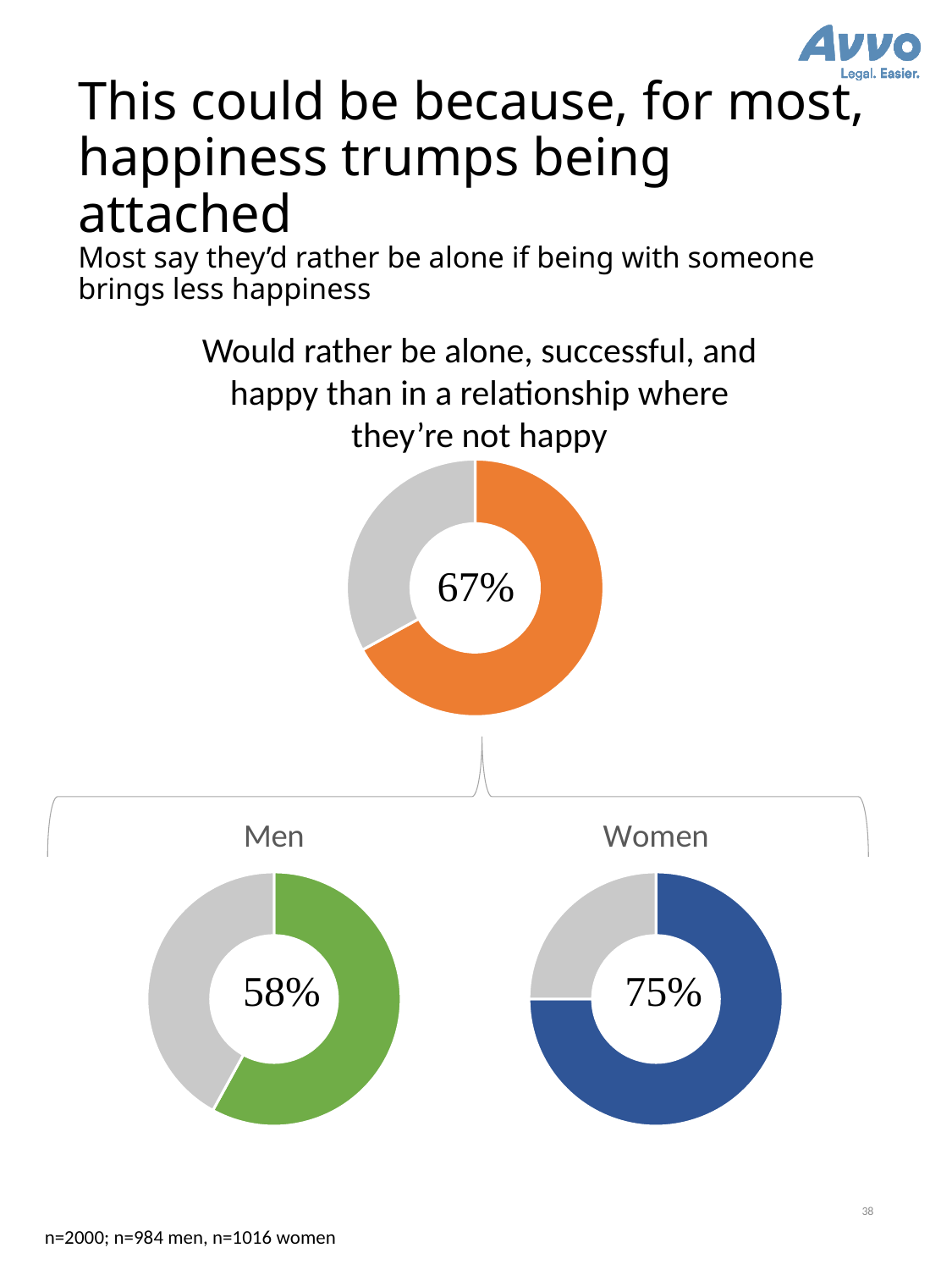
How many donut charts are shown on the slide? 3 Of the three donut charts on the slide, which one shows the highest percentage? Women In the 'Men' chart at the bottom left, what percentage is shown? 58% What kind of chart is used for the 'Men' chart? Donut (pie) chart What is the difference between the percentage in the 'Women' chart and the percentage in the 'Men' chart? 17% What is the difference between the percentage in the 'Women' chart and the percentage in the top overall chart? 8% Of the three donut charts on the slide, which one shows the lowest percentage? Men What colour is the filled segment of the 'Women' chart? Blue In the top chart titled 'Would rather be alone, successful, and happy than in a relationship where they're not happy', what percentage is shown in the centre of the donut? 67% What is the difference between the percentage in the top overall chart and the percentage in the 'Men' chart? 9% Comparing the 'Men' and 'Women' charts, which group has the higher percentage? Women In the 'Women' chart at the bottom right, what percentage is shown? 75%